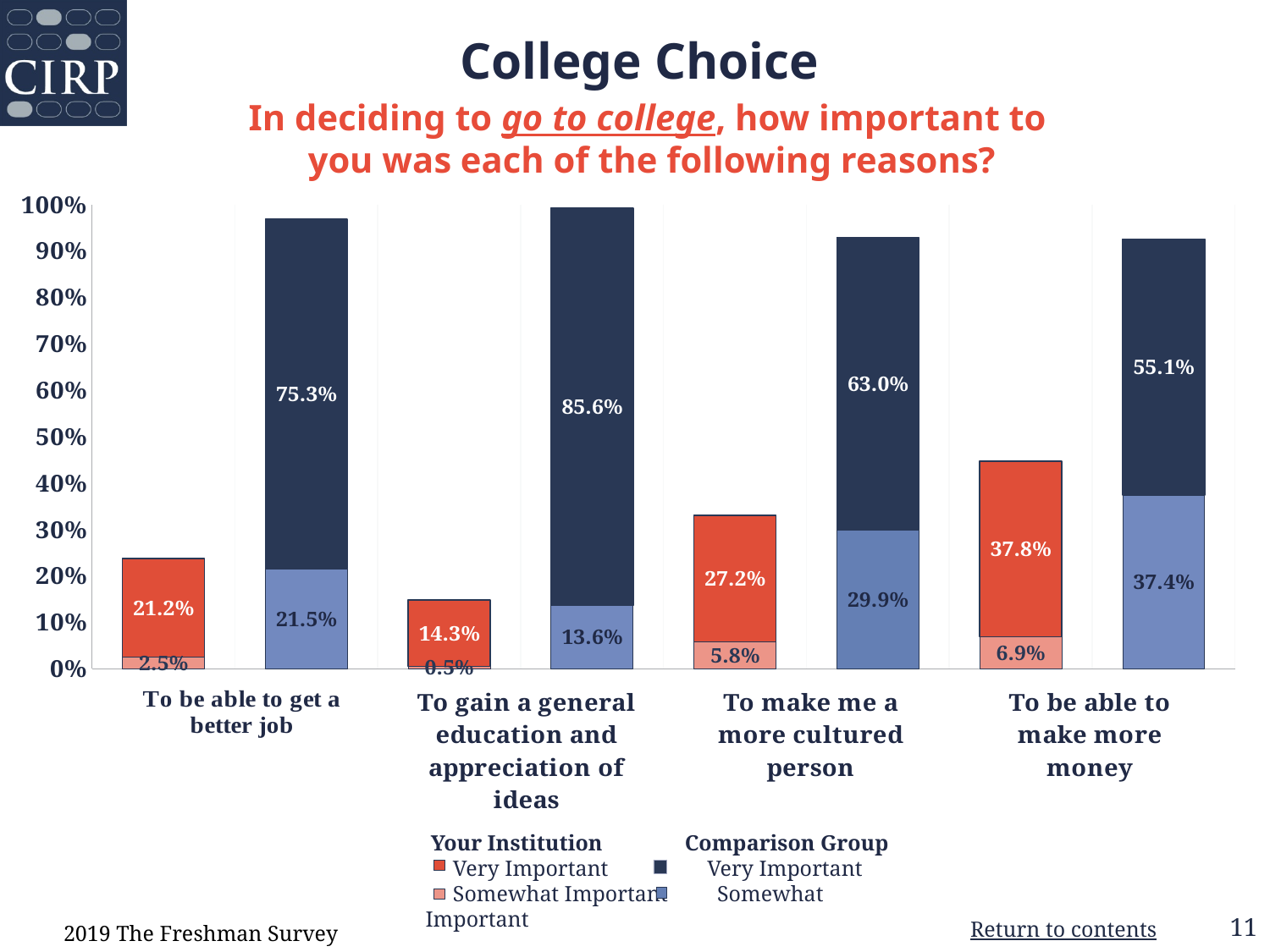
How many reasons (categories) are shown on the x axis? 4 What is the total height of the Your Institution stacked bar for "To be able to make more money"? 44.7% For "To be able to make more money", which is larger: the Your Institution Very Important percentage or the Comparison Group Somewhat Important percentage? Your Institution Very Important What percentage of Your Institution students rated "To be able to make more money" as Somewhat Important? 6.9% How many series does the legend list? 4 What kind of chart is shown on the slide? Stacked bar chart Which reason has the lowest Your Institution Somewhat Important percentage? To gain a general education and appreciation of ideas What is the total height of the Comparison Group stacked bar for "To be able to get a better job"? 96.8% What percentage of Your Institution students rated "To be able to get a better job" as Very Important? 21.2% What percentage of the Comparison Group rated "To gain a general education and appreciation of ideas" as Very Important? 85.6% What is the difference between the Comparison Group and Your Institution Very Important percentages for "To make me a more cultured person"? 35.8% Which reason has the highest Comparison Group Very Important percentage? To gain a general education and appreciation of ideas